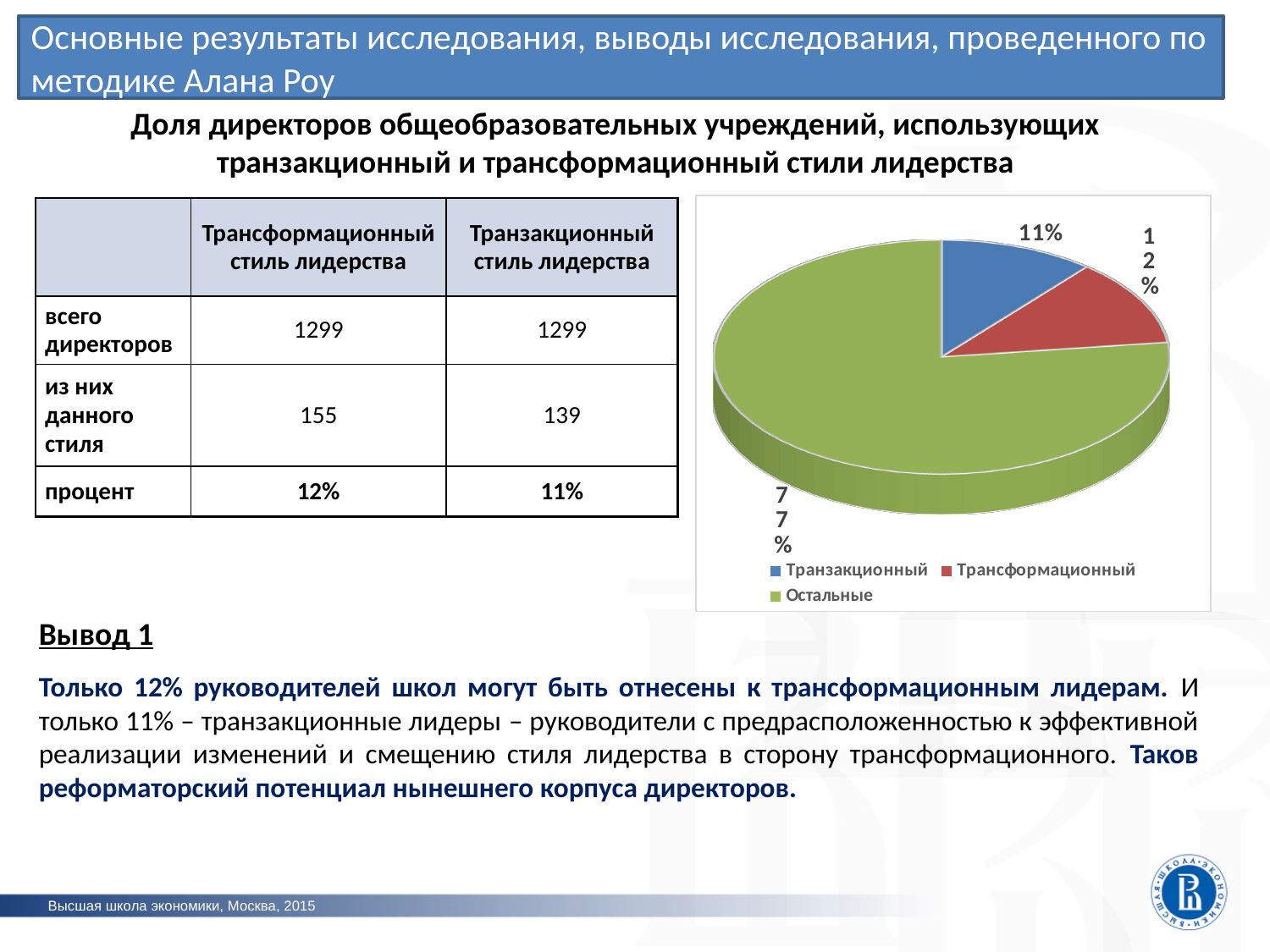
What kind of chart is shown on the slide? pie chart What is the difference in percentage points between the Остальные slice and the Трансформационный slice? 65 What share of the pie does the Трансформационный slice represent? 12% Which slice of the pie chart is the largest? Остальные What colour is the Транзакционный slice in the pie chart? blue What share of the pie does the Остальные slice represent? 77% What share of the pie does the Транзакционный slice represent? 11% Which is larger in the pie chart, the Транзакционный slice or the Трансформационный slice? Трансформационный What colour is the Остальные slice in the pie chart? green How many slices does the pie chart have? 3 Which slice of the pie chart is the smallest? Транзакционный How many entries does the legend of the pie chart list? 3